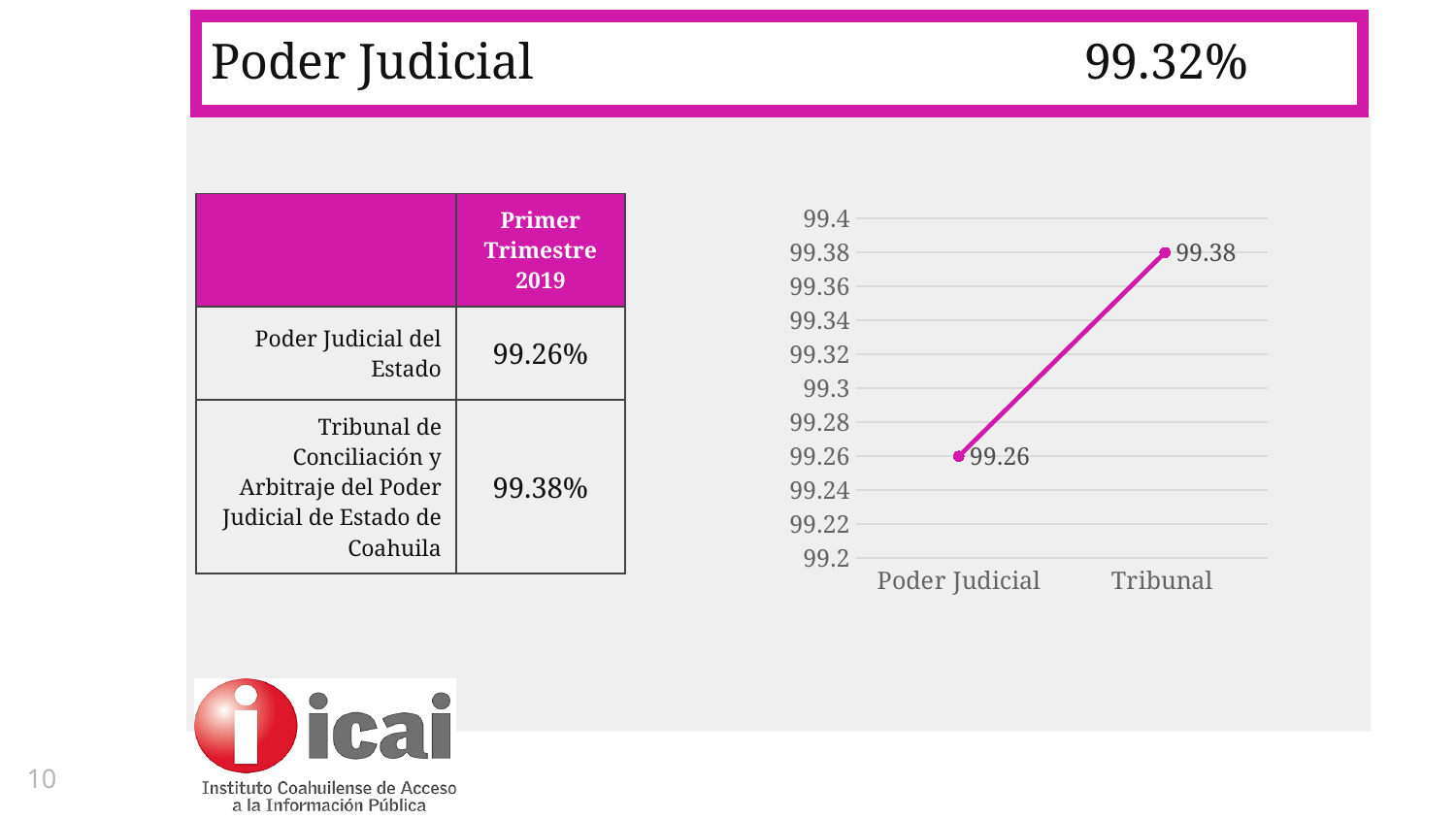
Do the values rise or fall from Poder Judicial to Tribunal? rise Which category has the lowest value in the chart? Poder Judicial What is the difference between the values for Tribunal and Poder Judicial? 0.12 Which category has the highest value in the chart? Tribunal What is the value for Tribunal in the chart? 99.38 Is the value for Tribunal greater or less than 99.3? greater What kind of chart is shown on the slide? line chart Which is larger, the value for Poder Judicial or the value for Tribunal? Tribunal Is the value for Poder Judicial greater or less than 99.3? less What is the value for Poder Judicial in the chart? 99.26 How many categories are plotted on the x axis of the chart? 2 What colour is the line in the chart? magenta